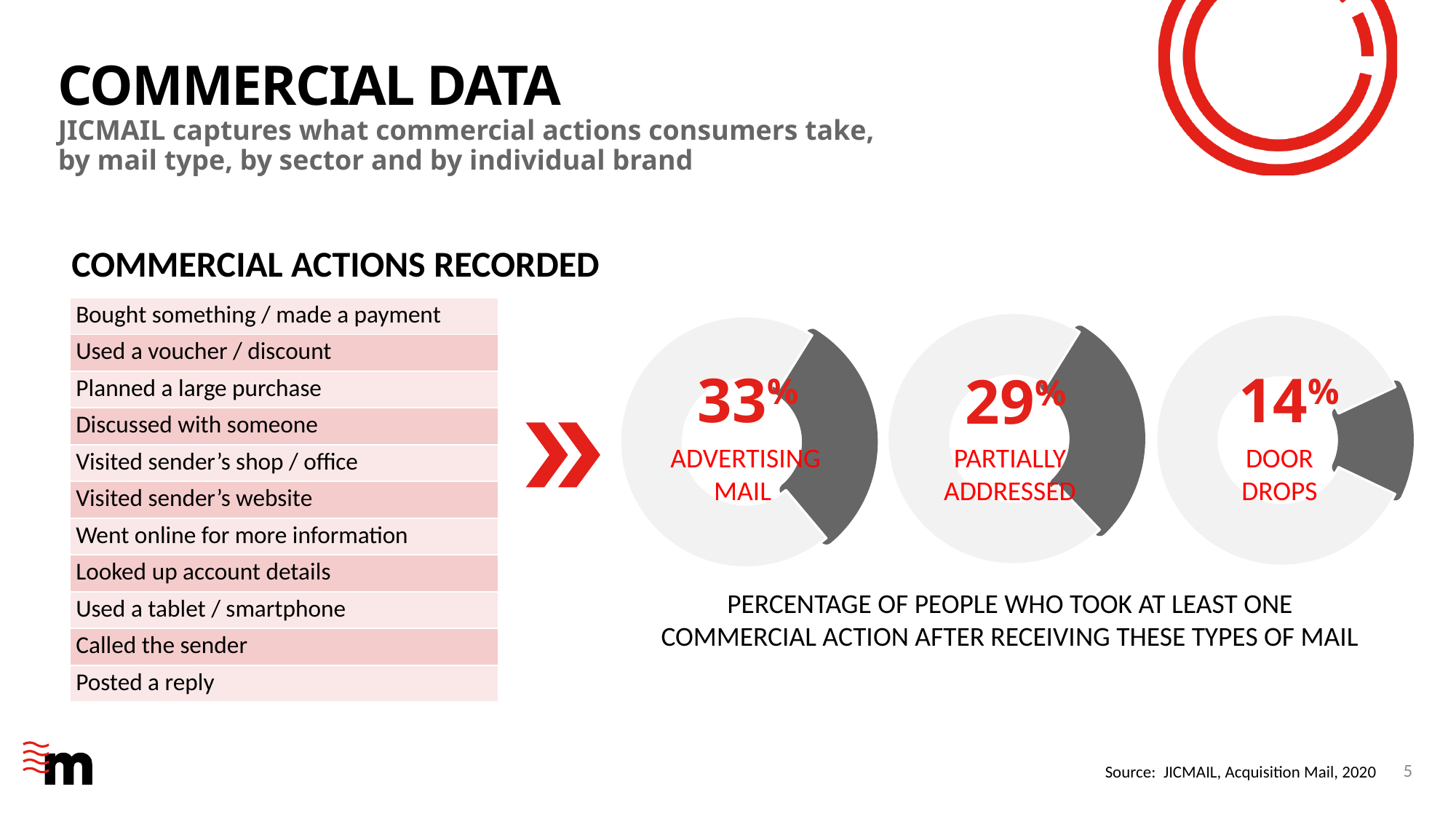
How many donut charts are shown on the slide? 3 What percentage of people took at least one commercial action after receiving advertising mail? 33% What kind of chart is used to show the percentages for each mail type? Donut chart What colour is used for the filled segment in each donut chart? Dark grey What is the difference in percentage points between advertising mail and partially addressed mail? 4 What percentage of people took at least one commercial action after receiving partially addressed mail? 29% Which has a higher percentage: partially addressed mail or door drops? Partially addressed What is the difference in percentage points between advertising mail and door drops? 19 Which type of mail has the highest percentage of people taking at least one commercial action? Advertising mail What is the source cited for the chart data? JICMAIL, Acquisition Mail, 2020 What percentage of people took at least one commercial action after receiving door drops? 14% Which type of mail has the lowest percentage of people taking at least one commercial action? Door drops